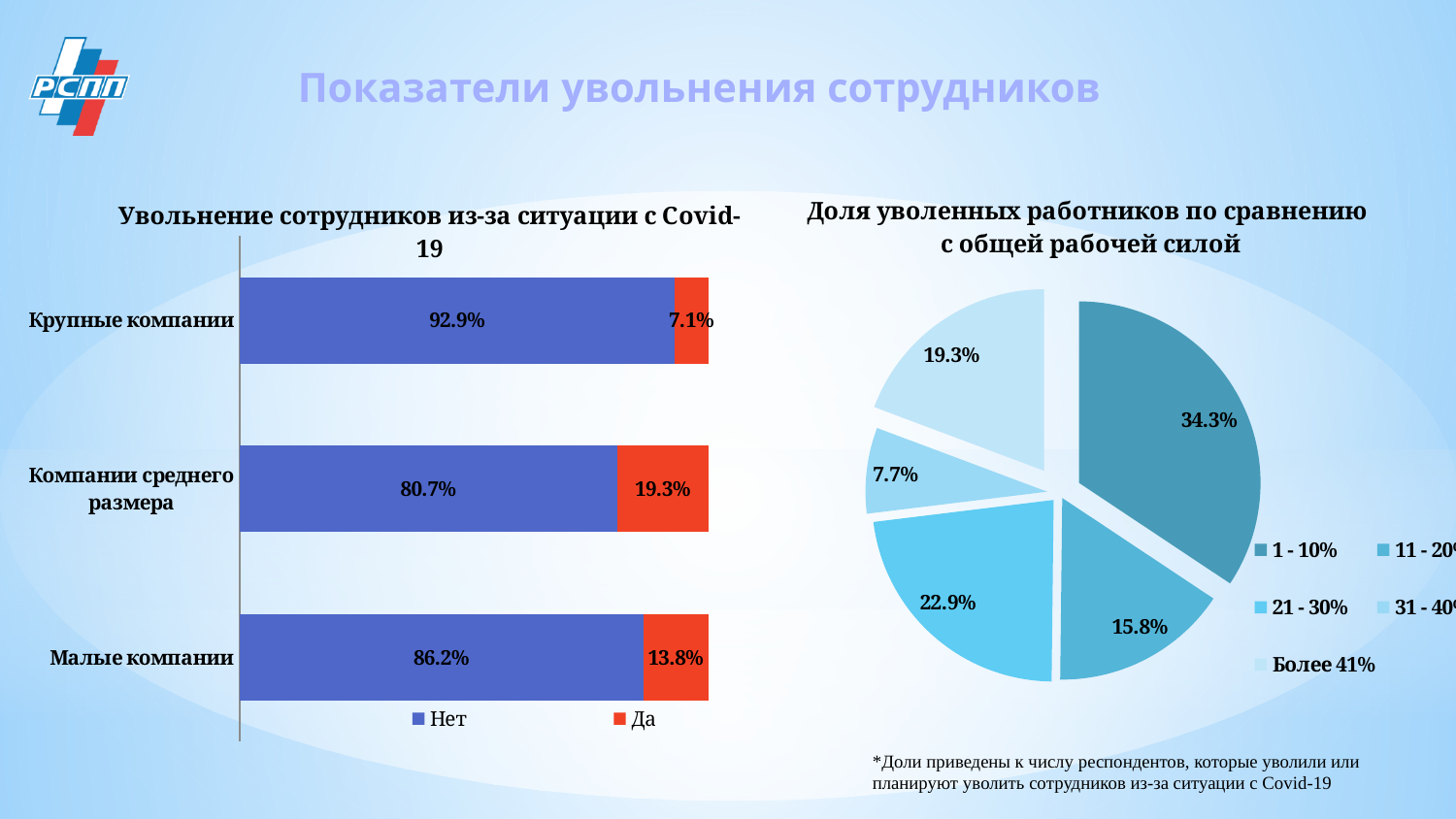
In the left bar chart, how many series does the legend list? 2 In the left bar chart, how many categories are shown? 3 In the left bar chart, what is the difference between the "Да" values for "Компании среднего размера" and "Крупные компании"? 12.2% In the left bar chart, which category has the lowest "Нет" value? Компании среднего размера What type of chart is the left chart titled "Увольнение сотрудников из-за ситуации с Covid-19"? Bar chart What type of chart is the right chart titled "Доля уволенных работников по сравнению с общей рабочей силой"? Pie chart In the left bar chart, what is the value of "Да" for "Крупные компании"? 7.1% In the left bar chart, what is the value of "Нет" for "Компании среднего размера"? 80.7% In the left bar chart, what is the value of "Да" for "Малые компании"? 13.8% In the left bar chart, which category has the highest "Да" value? Компании среднего размера In the right pie chart, what is the share of the "1 - 10%" slice? 34.3% In the right pie chart, what is the share of the "Более 41%" slice? 19.3%